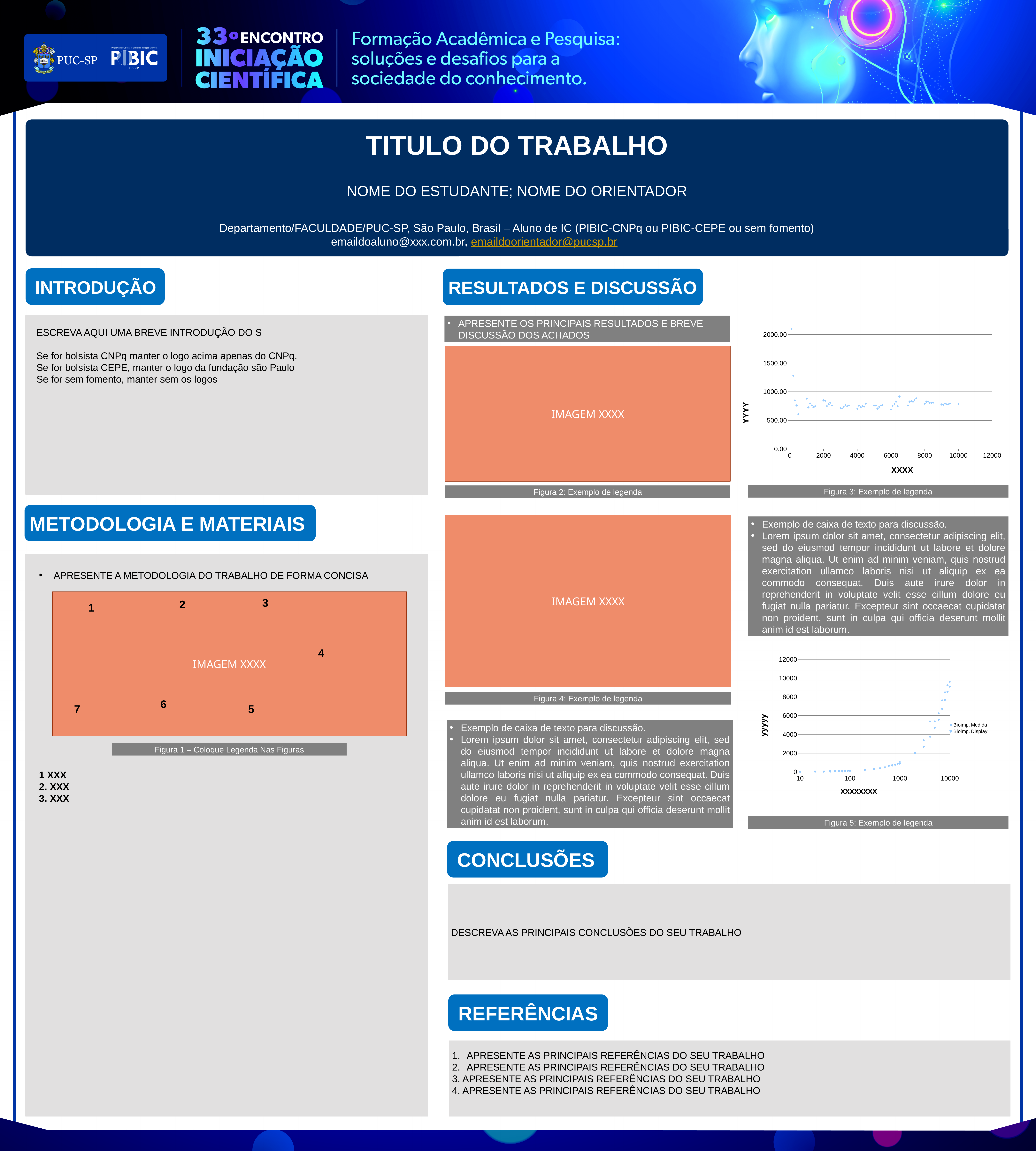
What kind of chart is Figura 3 (the chart captioned 'Figura 3: Exemplo de legenda')? scatter plot In Figura 5, what are the two series named in the legend? Bioimp. Medida and Bioimp. Display In Figura 3, what is the title of the x axis? XXXX In Figura 3, what is the maximum value shown on the x axis? 12000 In Figura 5, do the plotted values generally rise or fall as the x axis increases? rise What kind of chart is Figura 5 (the chart captioned 'Figura 5: Exemplo de legenda')? scatter plot In Figura 5, is the highest plotted value greater or less than 6000? greater How many series does the legend of Figura 5 list? 2